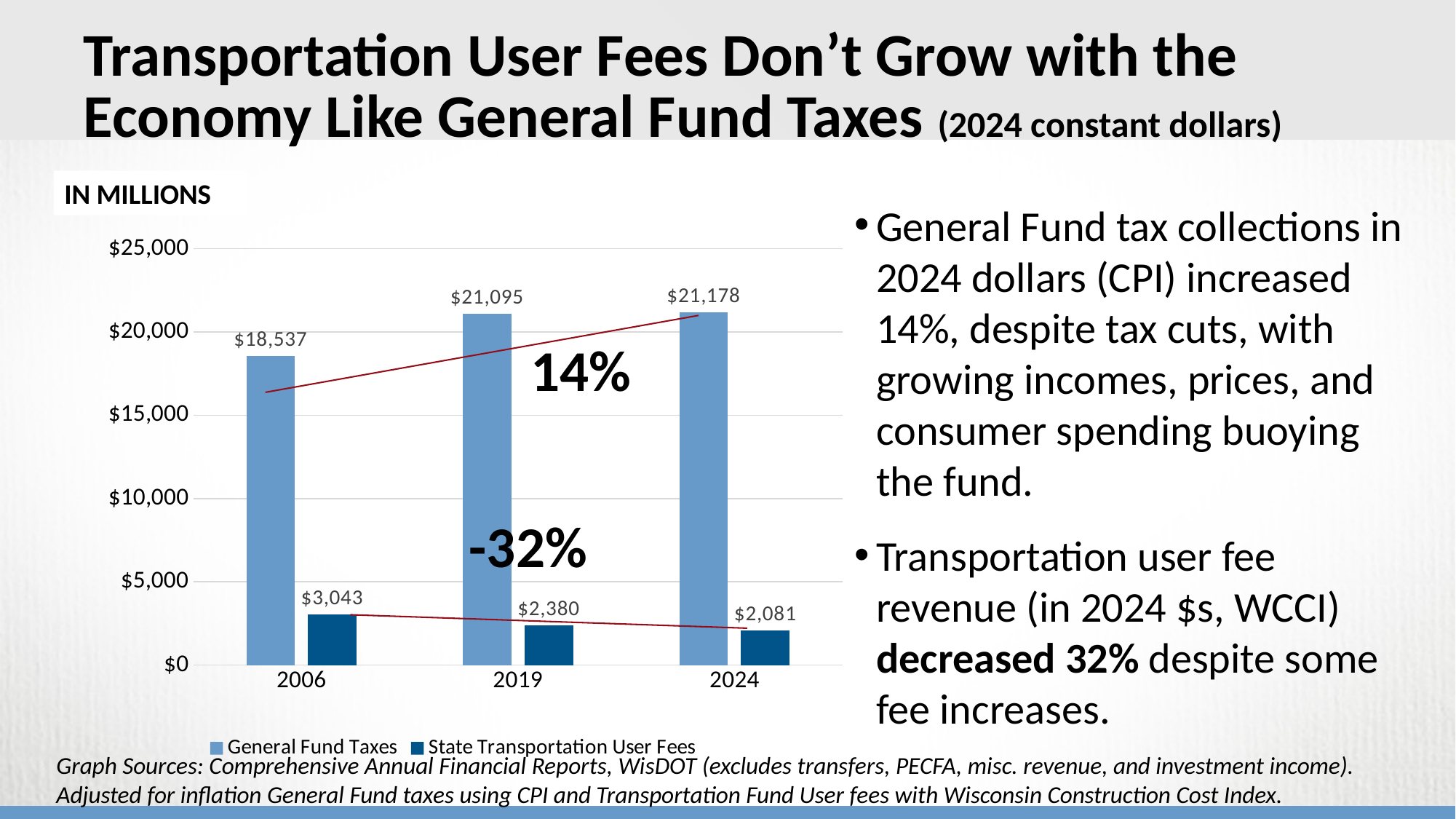
How many years are shown on the x axis of the chart? 3 What is the value of State Transportation User Fees in 2024? $2,081 Is the value for General Fund Taxes in 2006 greater or less than $20,000? less What is the value of State Transportation User Fees in 2006? $3,043 How many series does the chart legend list? 2 What is the difference between State Transportation User Fees in 2006 and in 2019? $663 What is the value of General Fund Taxes in 2019? $21,095 What kind of chart is shown on the slide? Bar chart In which year are General Fund Taxes highest? 2024 Which is larger: State Transportation User Fees in 2006 or in 2019? 2006 What is the difference between General Fund Taxes in 2024 and in 2006? $2,641 In which year are State Transportation User Fees lowest? 2024